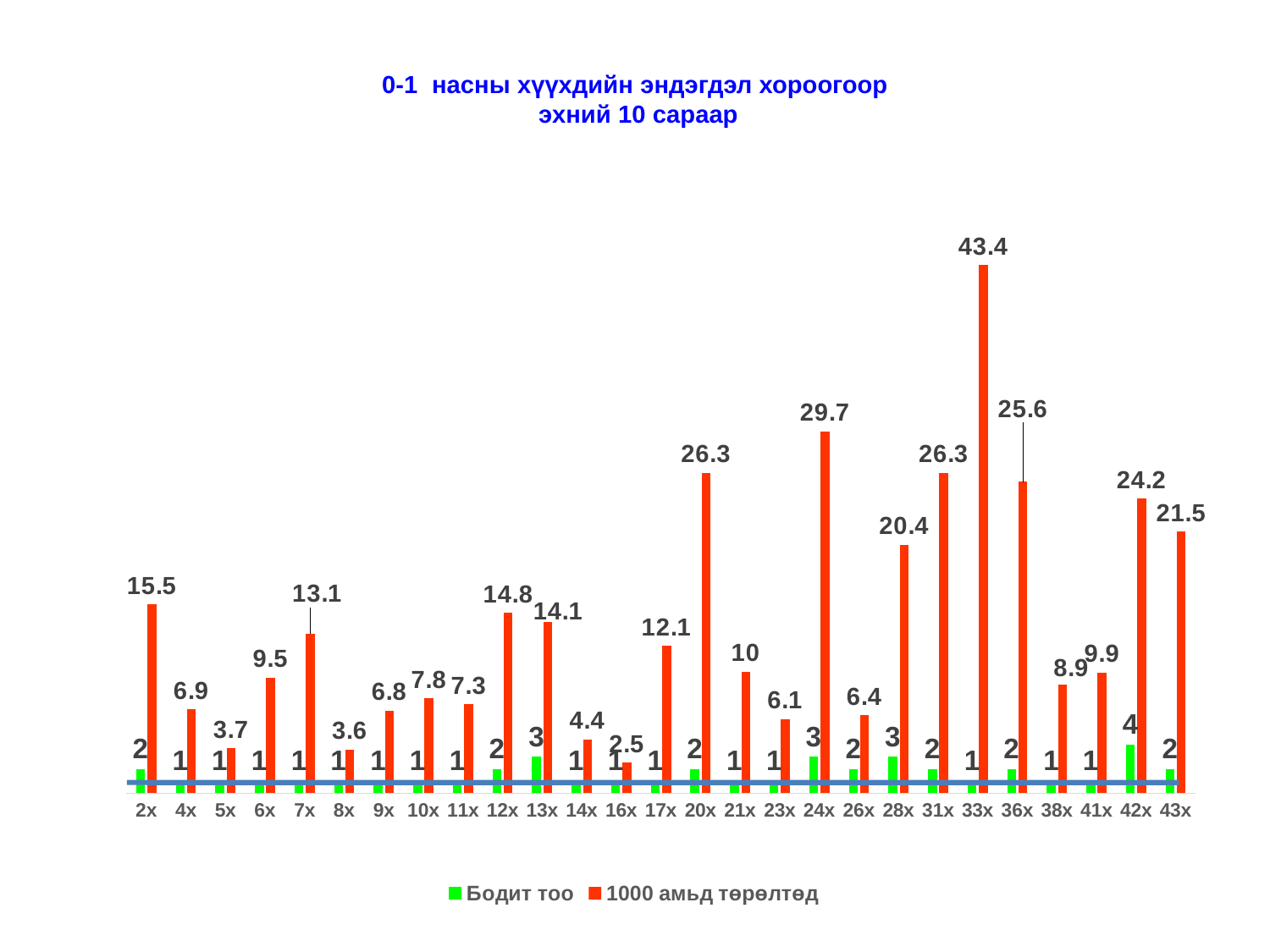
What is the difference between the 1000 амьд төрөлтөд values for 33x and 24x? 13.7 Which has a larger 1000 амьд төрөлтөд value, 2x or 7x? 2x Which colour represents the Бодит тоо series? Green What is the value of the 1000 амьд төрөлтөд series for 24x? 29.7 Which category has the lowest value in the 1000 амьд төрөлтөд series? 16x How many categories are shown on the x axis? 27 Which category has the highest value in the 1000 амьд төрөлтөд series? 33x What kind of chart is shown on the slide? Bar chart How many series does the legend list? 2 What is the title of the chart? 0-1 насны хүүхдийн эндэгдэл хороогоор эхний 10 сараар What is the Бодит тоо value for 42x? 4 What is the value of the 1000 амьд төрөлтөд series for 33x? 43.4